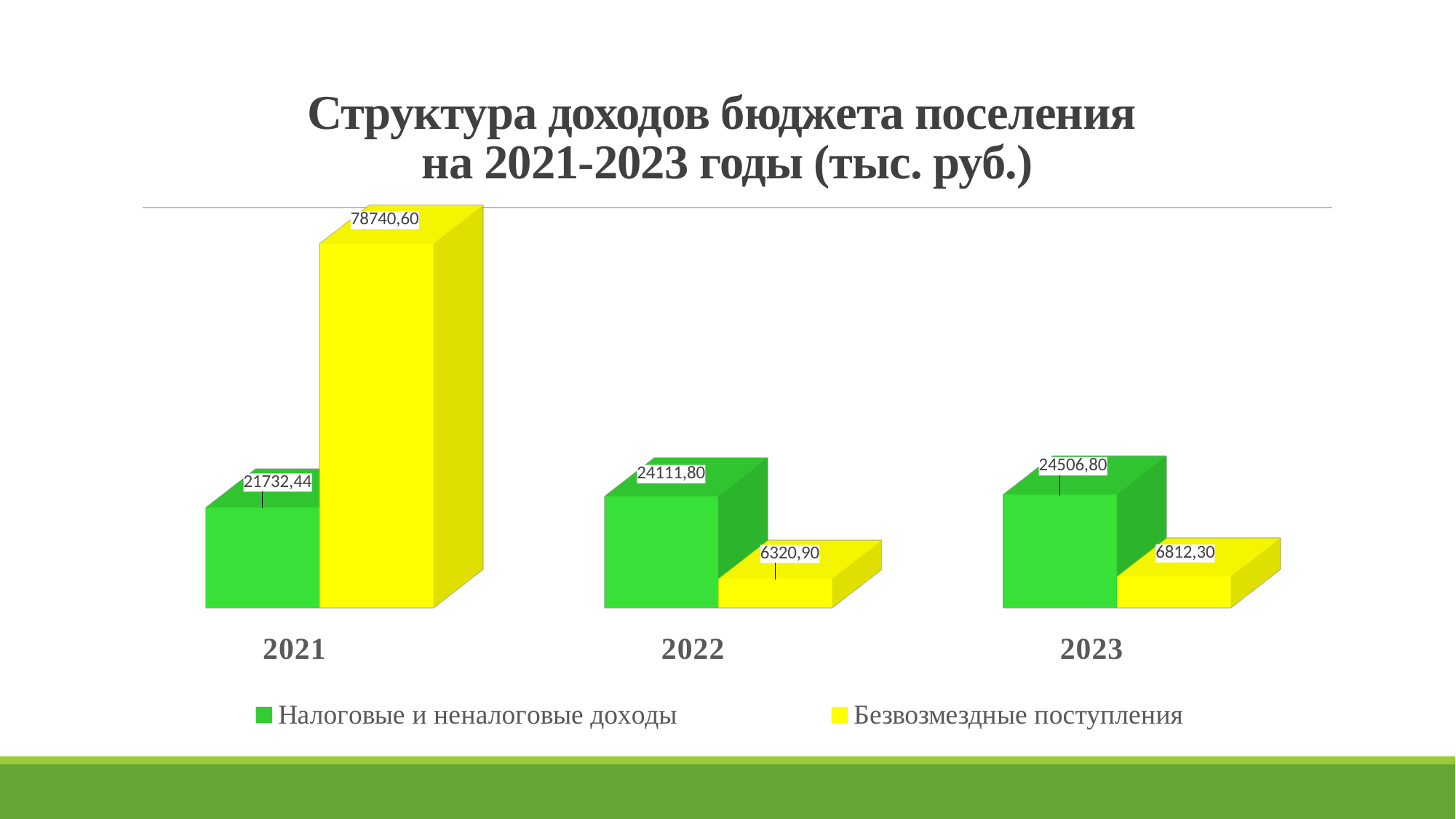
What is the value of Безвозмездные поступления for 2021? 78740,60 How many series does the legend list? 2 How many years are shown on the x axis? 3 By how much did Налоговые и неналоговые доходы increase from 2022 to 2023? 395,00 In which year is Безвозмездные поступления lowest? 2022 In 2022, which is larger: Налоговые и неналоговые доходы or Безвозмездные поступления? Налоговые и неналоговые доходы What is the value of Безвозмездные поступления for 2023? 6812,30 In which year is Безвозмездные поступления highest? 2021 What is the difference between Безвозмездные поступления and Налоговые и неналоговые доходы in 2021? 57008,16 In which year is Налоговые и неналоговые доходы lowest? 2021 What is the value of Налоговые и неналоговые доходы for 2021? 21732,44 Does Налоговые и неналоговые доходы rise or fall from 2021 to 2023? rise